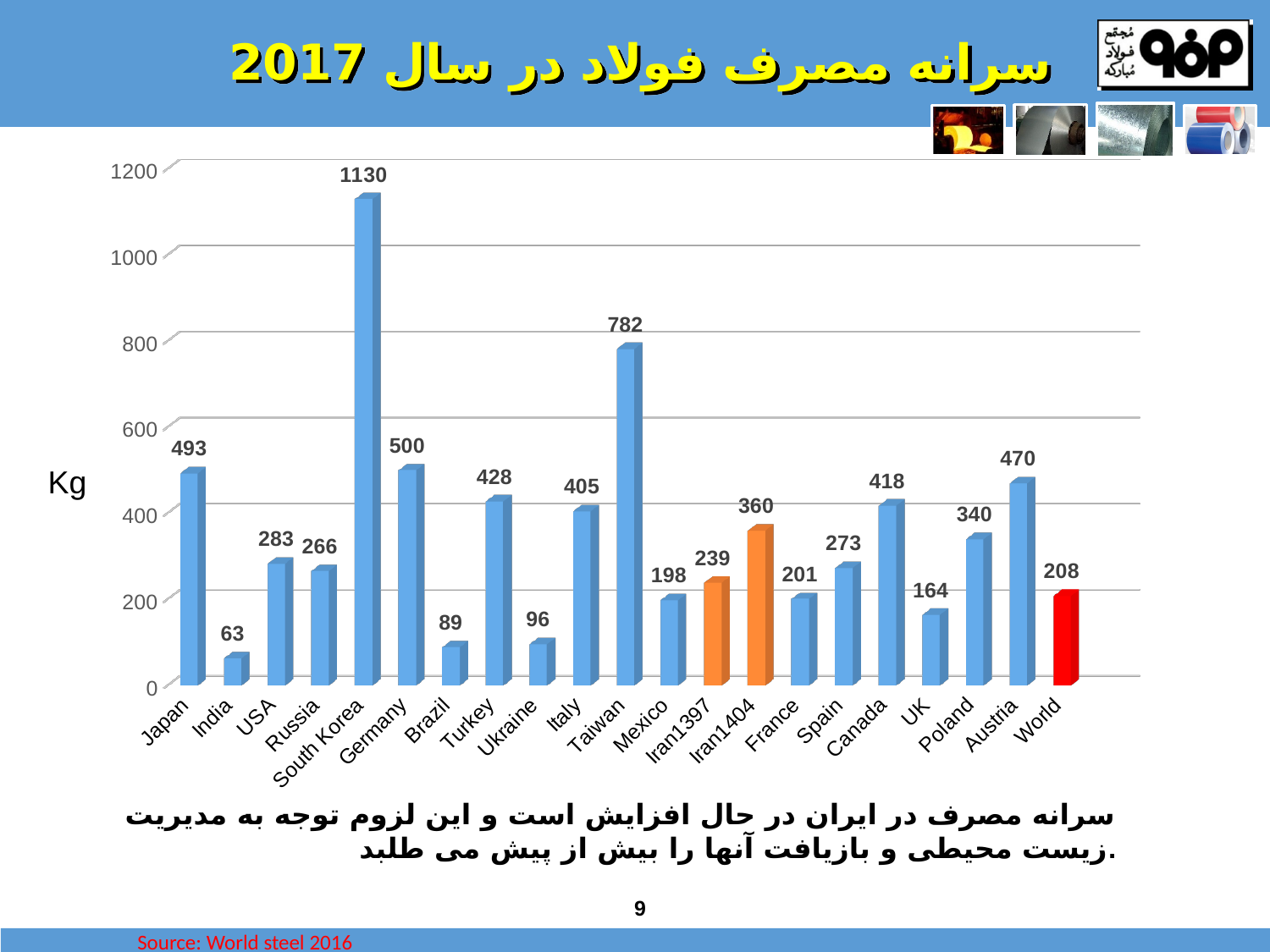
Which category has the lowest value? India Is the value for Canada greater or less than 400? greater What is the difference between the values for Iran1404 and Iran1397? 121 What is the difference between the values for Taiwan and Germany? 282 What unit label is shown on the y axis? Kg What is the value for Iran1404? 360 What is the value for South Korea? 1130 What is the value for World? 208 What kind of chart is shown on the slide? bar chart Which country has the highest value? South Korea How many categories are shown on the x axis? 21 Which is larger, the value for Japan or the value for Austria? Japan